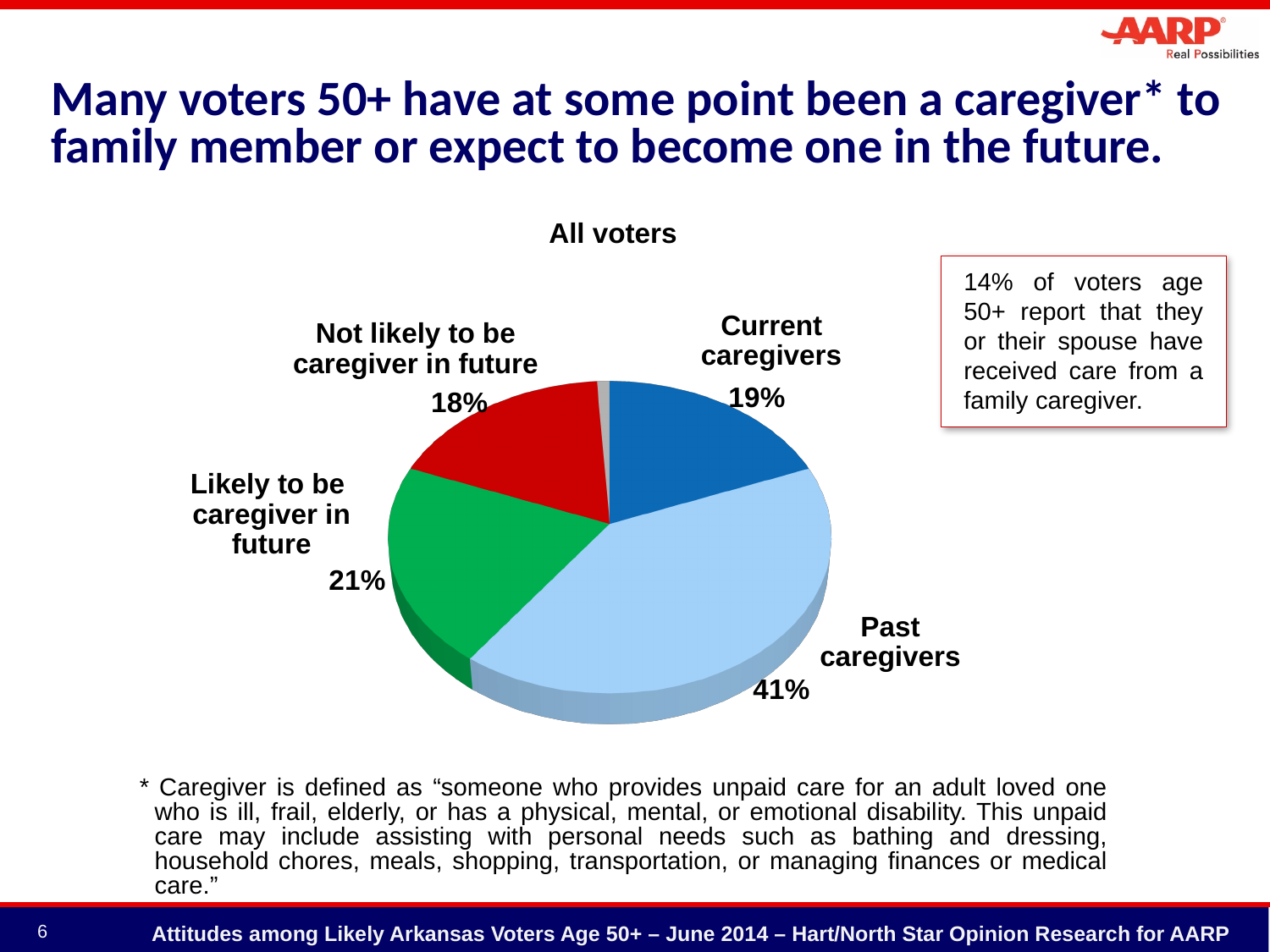
What percentage of voters are likely to be a caregiver in the future? 21% Which category has the largest share of the pie? Past caregivers What kind of chart is shown on the slide? Pie chart What is the combined percentage of current caregivers and past caregivers? 60% What percentage of voters are not likely to be a caregiver in the future? 18% What is the title of the chart? All voters Which labeled category has the smallest share of the pie? Not likely to be caregiver in future What percentage of voters are current caregivers? 19% Which is larger: the share of voters likely to be a caregiver in the future or the share not likely to be a caregiver in the future? Likely to be caregiver in future What percentage of voters are past caregivers? 41% What is the difference in percentage points between past caregivers and current caregivers? 22 What colour is the slice for past caregivers? Light blue